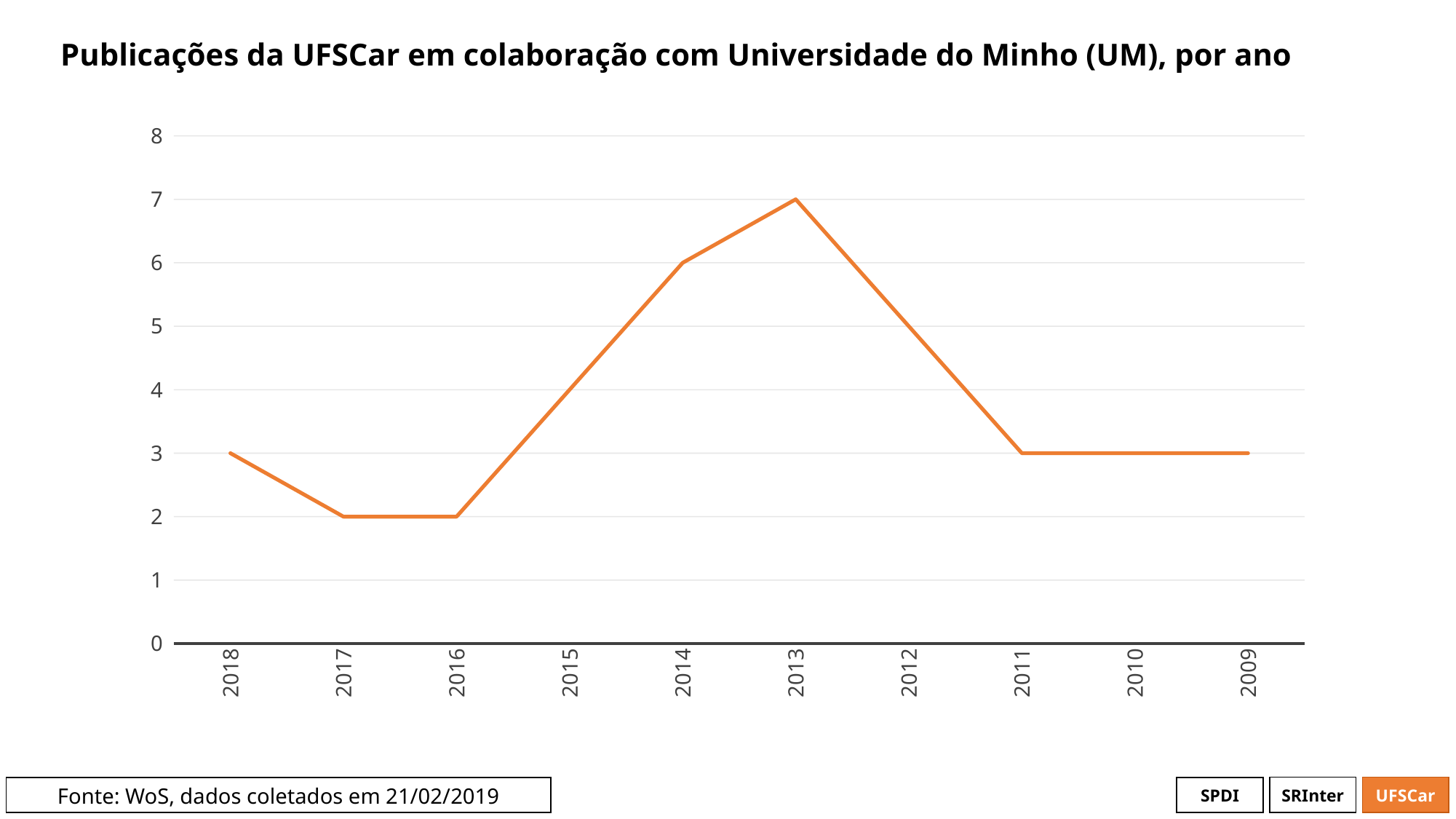
Do the values rise or fall from 2016 to 2013? rise What is the number of publications for 2017? 2 What is the number of publications for 2018? 3 What is the difference between the values for 2013 and 2014? 1 What is the number of publications for 2009? 3 Is the value for 2015 greater or less than 3? greater Which year has a larger value, 2014 or 2018? 2014 What type of chart is shown on the slide? line chart Which year has the highest number of publications? 2013 What is the number of publications for 2013? 7 How many years are plotted on the x axis? 10 What is the number of publications for 2014? 6